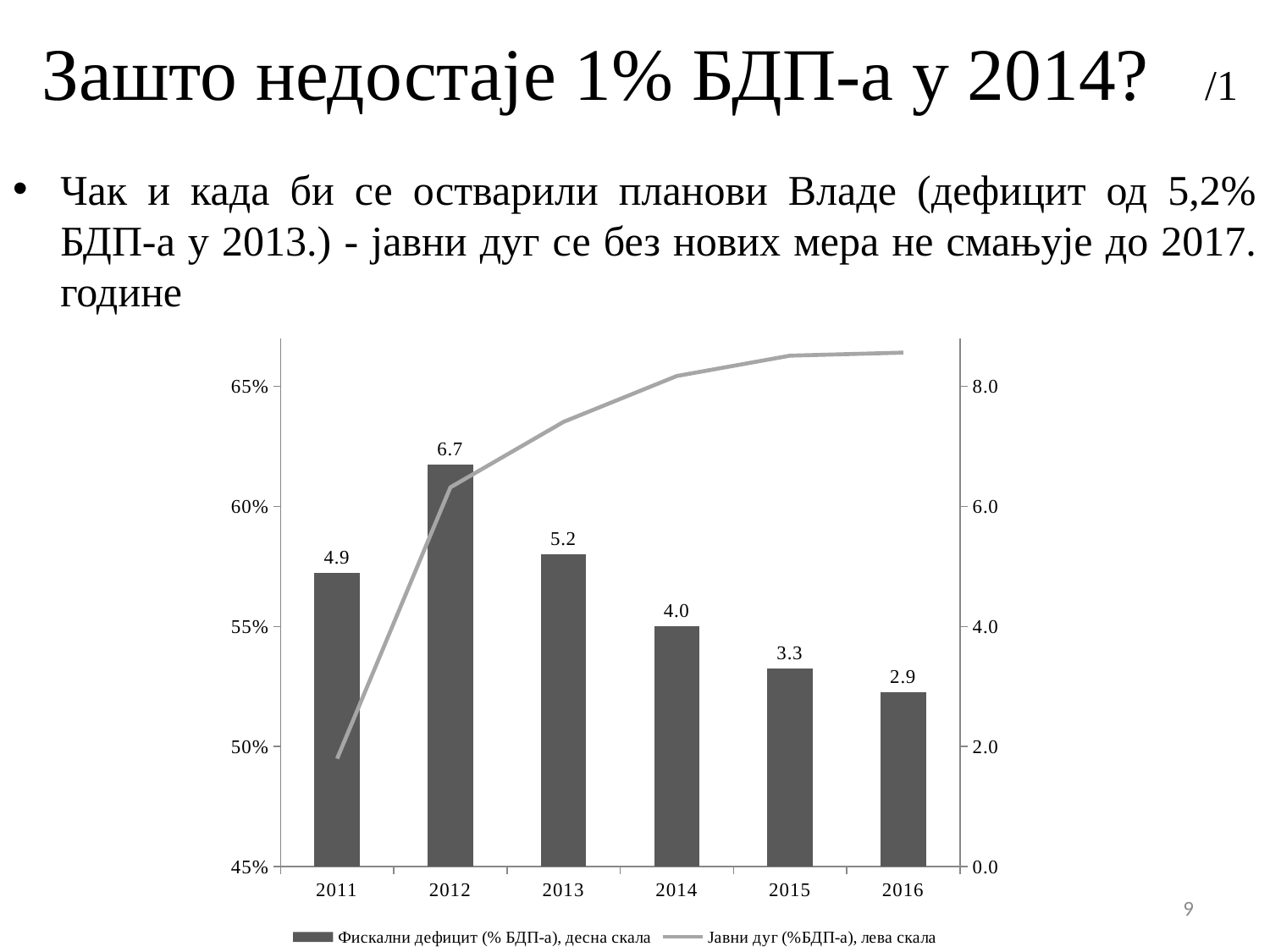
Is the public debt value for 2014 greater or less than 65%? greater How many years are shown on the x axis? 6 What is the fiscal deficit value shown for 2014? 4.0 Does the fiscal deficit rise or fall from 2012 to 2016? fall Which year has the highest fiscal deficit bar? 2012 Is the public debt value for 2011 greater or less than 50%? less What is the fiscal deficit value shown for 2012? 6.7 Which is larger, the fiscal deficit for 2011 or for 2015? 2011 What is the fiscal deficit value shown for 2016? 2.9 Which year has the lowest fiscal deficit bar? 2016 What is the difference between the fiscal deficit values for 2012 and 2013? 1.5 How many series does the legend list? 2